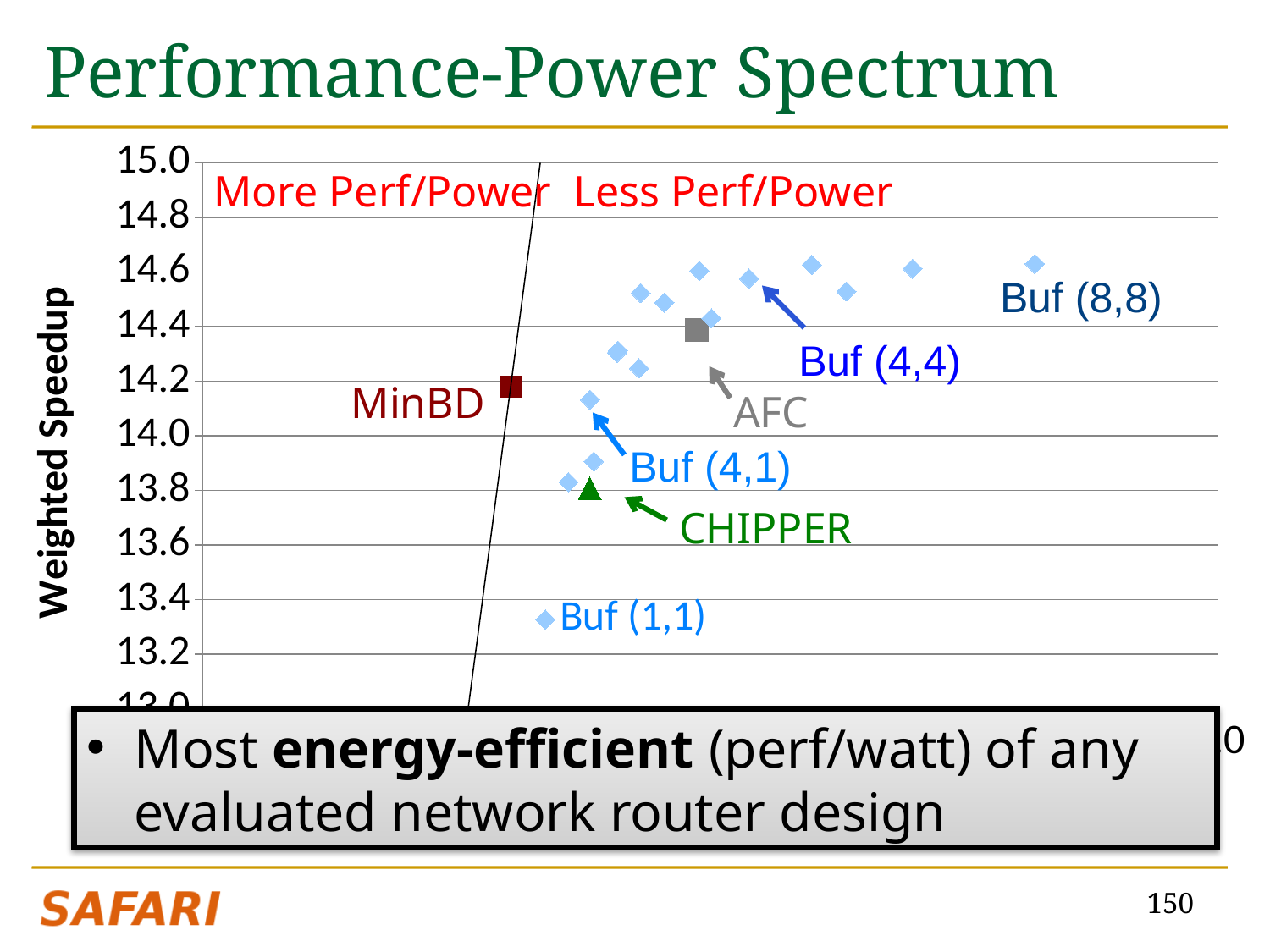
What is the title of the chart on the slide? Performance-Power Spectrum Is the weighted speedup for CHIPPER greater or less than 14.0? less What kind of chart is shown on the slide? scatter chart Is the weighted speedup for Buf (1,1) greater or less than 13.4? less Is the weighted speedup for Buf (8,8) greater or less than 14.4? greater Which labeled design has the lowest weighted speedup? Buf (1,1) Which has the higher weighted speedup, Buf (4,4) or Buf (4,1)? Buf (4,4) Which has the higher weighted speedup, AFC or MinBD? AFC What is the label of the vertical axis? Weighted Speedup Which has the higher weighted speedup, MinBD or CHIPPER? MinBD